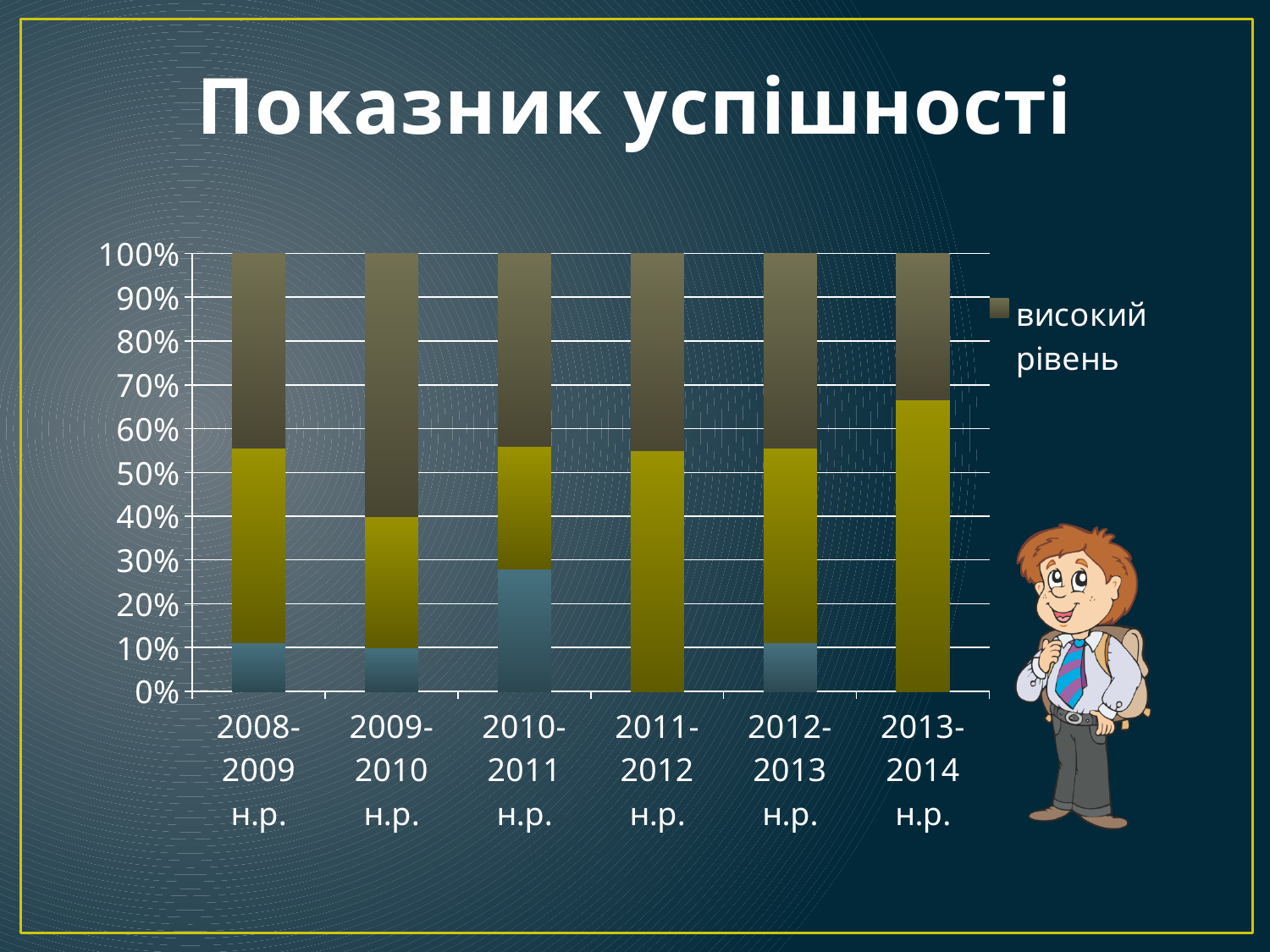
What is the title of the chart? Показник успішності Is the "високий рівень" share for 2013-2014 н.р. greater or less than 40%? less Which year has a larger "високий рівень" share, 2009-2010 н.р. or 2013-2014 н.р.? 2009-2010 н.р. What series name is shown in the chart legend? високий рівень What is the highest value shown on the vertical axis? 100% In which school year is the blue (bottom) segment the largest? 2010-2011 н.р. How many school years (categories) are shown on the x axis? 6 Is the "високий рівень" share for 2009-2010 н.р. greater or less than 50%? greater In which school year is the "високий рівень" segment the largest? 2009-2010 н.р. What kind of chart is shown on the slide? stacked bar chart In which school year is the "високий рівень" segment the smallest? 2013-2014 н.р. In which school year is the yellow (middle) segment the largest? 2013-2014 н.р.